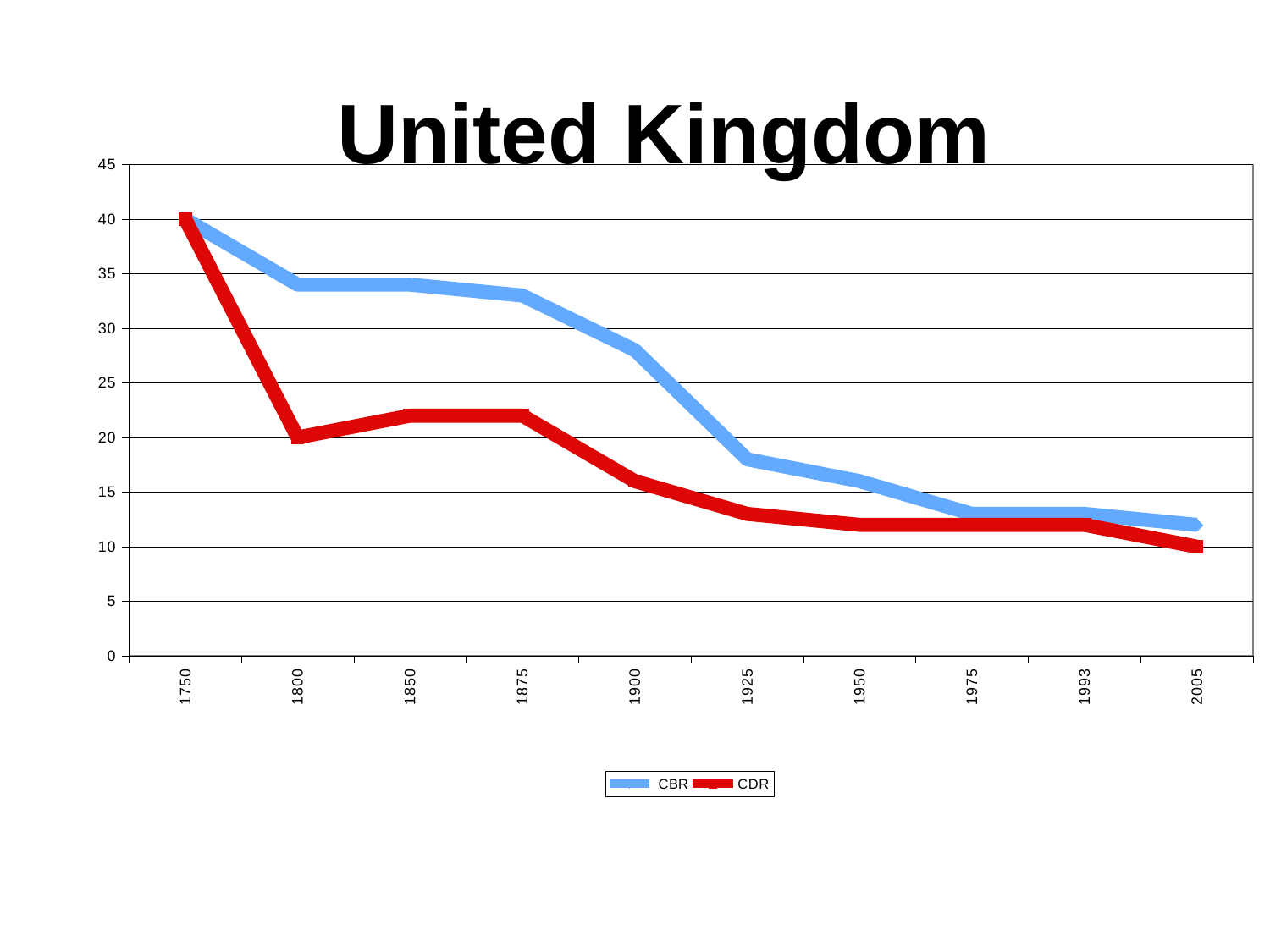
Is the CDR value for 1875 greater or less than 20? greater How many series does the legend list? 2 In which year is the CDR value lowest? 2005 How many years are plotted along the x axis? 10 What kind of chart is shown on the slide? line chart In which year is the CBR value highest? 1750 Is the CBR value for 1900 greater or less than 25? greater In 1925, which series has the larger value, CBR or CDR? CBR Is the CDR value for 1800 greater or less than 30? less Does the CBR line rise or fall from 1750 to 2005? fall What is the title of the chart? United Kingdom